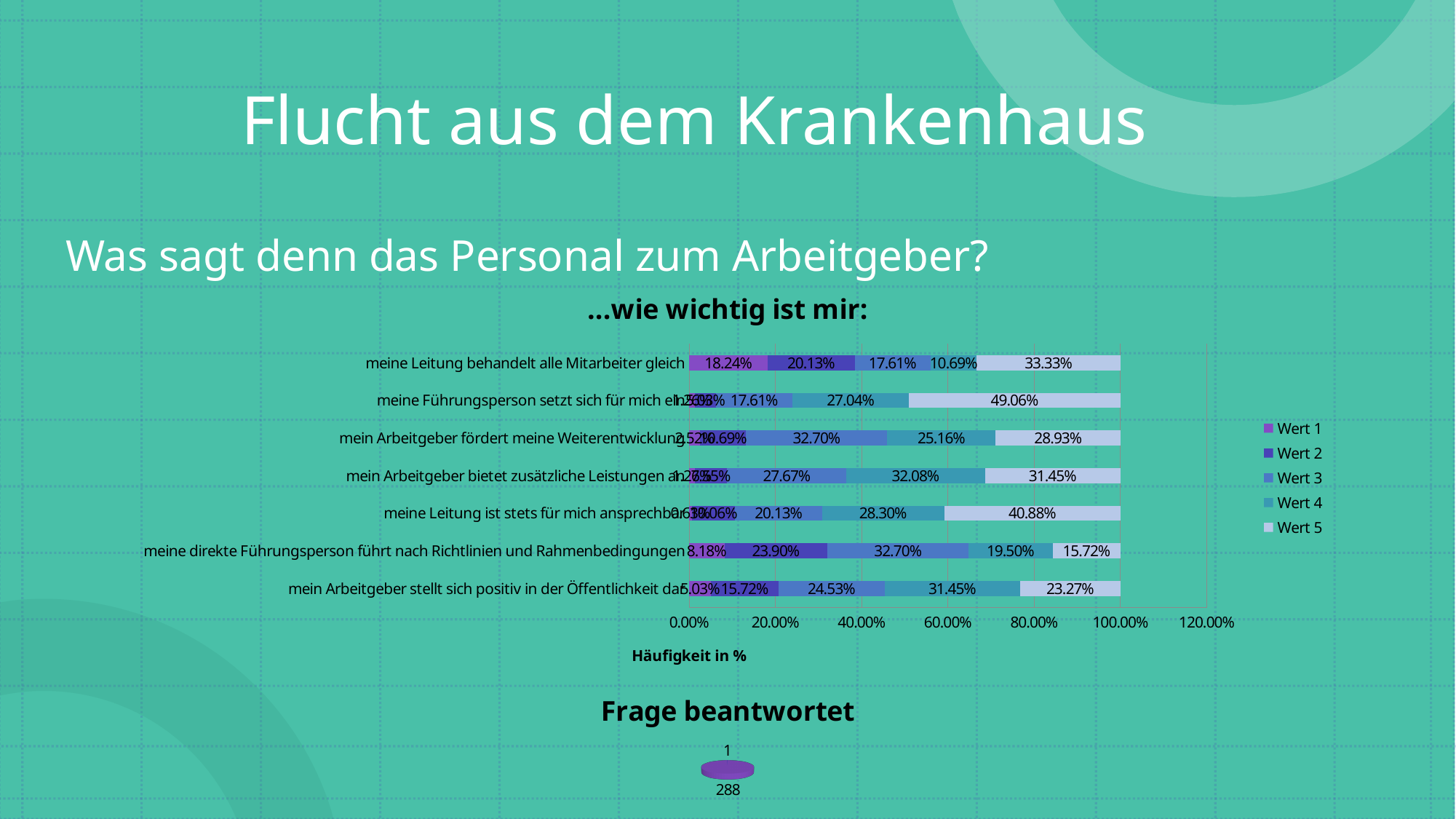
In the chart "...wie wichtig ist mir:", what is the Wert 3 value for "meine Leitung ist stets für mich ansprechbar"? 20.13% In the chart "...wie wichtig ist mir:", what is the Wert 5 value for "meine Führungsperson setzt sich für mich ein"? 49.06% In the chart "...wie wichtig ist mir:", which has the larger Wert 4 value: "mein Arbeitgeber stellt sich positiv in der Öffentlichkeit dar" or "meine direkte Führungsperson führt nach Richtlinien und Rahmenbedingungen"? mein Arbeitgeber stellt sich positiv in der Öffentlichkeit dar How many categories are shown in the chart "...wie wichtig ist mir:"? 7 In the chart "...wie wichtig ist mir:", how much larger is the Wert 5 value than the Wert 1 value for "meine Leitung behandelt alle Mitarbeiter gleich"? 15.09% How many series does the legend of the chart "...wie wichtig ist mir:" list? 5 In the chart "...wie wichtig ist mir:", which category has the highest Wert 1 value? meine Leitung behandelt alle Mitarbeiter gleich In the chart "...wie wichtig ist mir:", what is the Wert 5 value for "meine Leitung behandelt alle Mitarbeiter gleich"? 33.33% In the chart "...wie wichtig ist mir:", which category has the lowest Wert 5 value? meine direkte Führungsperson führt nach Richtlinien und Rahmenbedingungen In the chart "...wie wichtig ist mir:", what is the Wert 1 value for "meine direkte Führungsperson führt nach Richtlinien und Rahmenbedingungen"? 8.18% In the chart "...wie wichtig ist mir:", which category has the highest Wert 5 value? meine Führungsperson setzt sich für mich ein